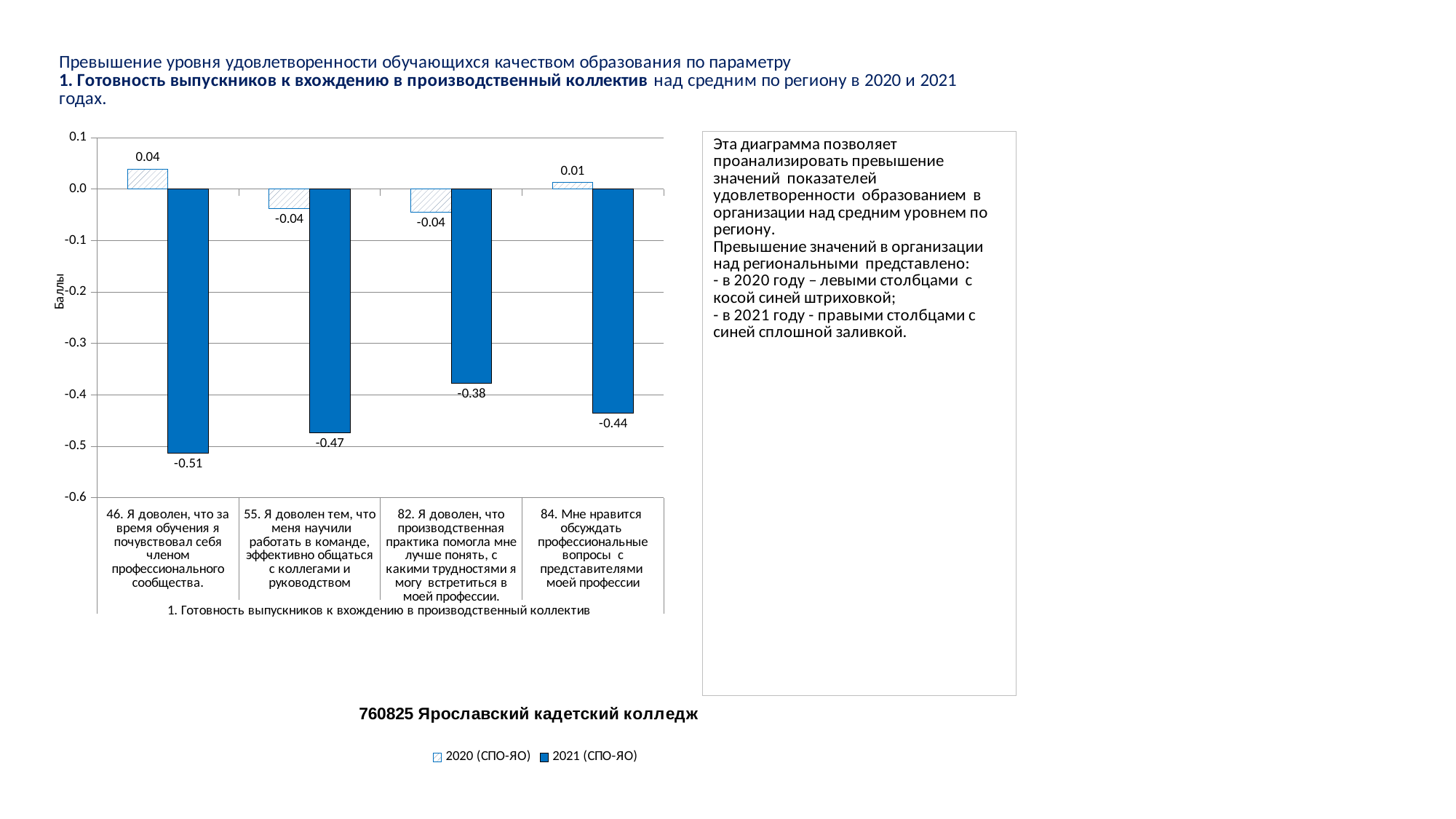
What is the label of the y axis of the chart? Баллы Which question has the highest 2020 (СПО-ЯО) value? 46. Я доволен, что за время обучения я почувствовал себя членом профессионального сообщества. What type of chart is shown on the slide? bar chart What is the 2020 (СПО-ЯО) value for question 84 ("Мне нравится обсуждать профессиональные вопросы с представителями моей профессии")? 0.01 How many questions (categories) are shown on the x axis of the chart? 4 Which is larger for question 84: the 2020 (СПО-ЯО) value or the 2021 (СПО-ЯО) value? 2020 (СПО-ЯО) What is the difference between the 2020 and 2021 (СПО-ЯО) values for question 46? 0.55 What is the 2020 (СПО-ЯО) value for question 55 ("Я доволен тем, что меня научили работать в команде...")? -0.04 What is the 2021 (СПО-ЯО) value for question 82 ("Я доволен, что производственная практика помогла мне лучше понять...")? -0.38 What is the 2021 (СПО-ЯО) value for question 46 ("Я доволен, что за время обучения я почувствовал себя членом профессионального сообщества")? -0.51 How many series does the chart legend list? 2 Which question has the lowest 2021 (СПО-ЯО) value? 46. Я доволен, что за время обучения я почувствовал себя членом профессионального сообщества.